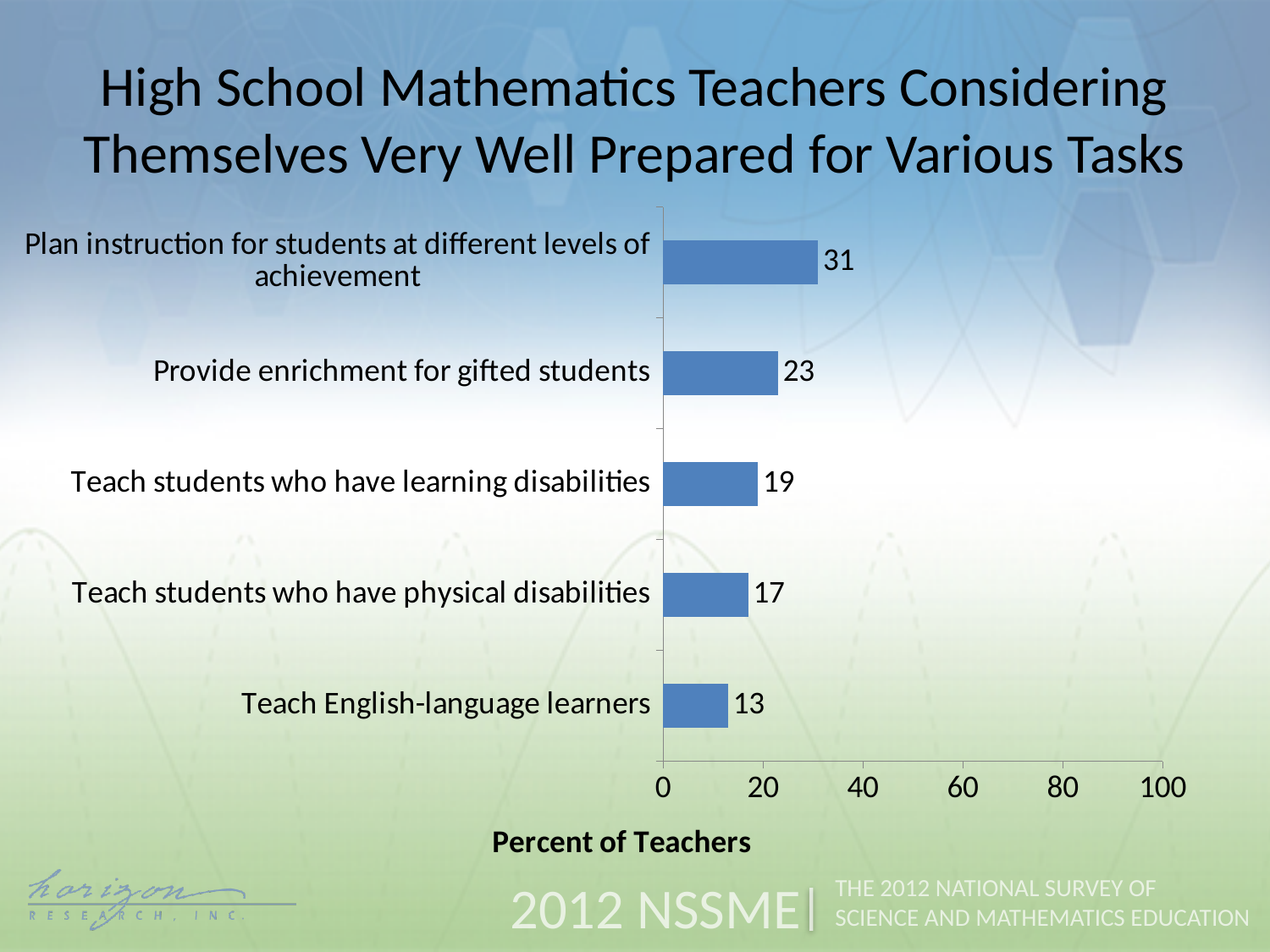
What is the value for 'Teach students who have learning disabilities'? 19 What percent of high school mathematics teachers consider themselves very well prepared to plan instruction for students at different levels of achievement? 31 Which is larger: the value for 'Provide enrichment for gifted students' or 'Teach students who have physical disabilities'? Provide enrichment for gifted students What is the difference between the values for 'Teach students who have learning disabilities' and 'Teach students who have physical disabilities'? 2 What kind of chart is shown on the slide? Bar chart What is the value for 'Teach English-language learners'? 13 What is the label of the horizontal axis? Percent of Teachers What is the difference between the values for 'Provide enrichment for gifted students' and 'Teach English-language learners'? 10 Which task has the lowest percent of teachers considering themselves very well prepared? Teach English-language learners Which task has the highest percent of teachers considering themselves very well prepared? Plan instruction for students at different levels of achievement Is the value for 'Plan instruction for students at different levels of achievement' greater or less than 40? less How many tasks are shown in the chart? 5